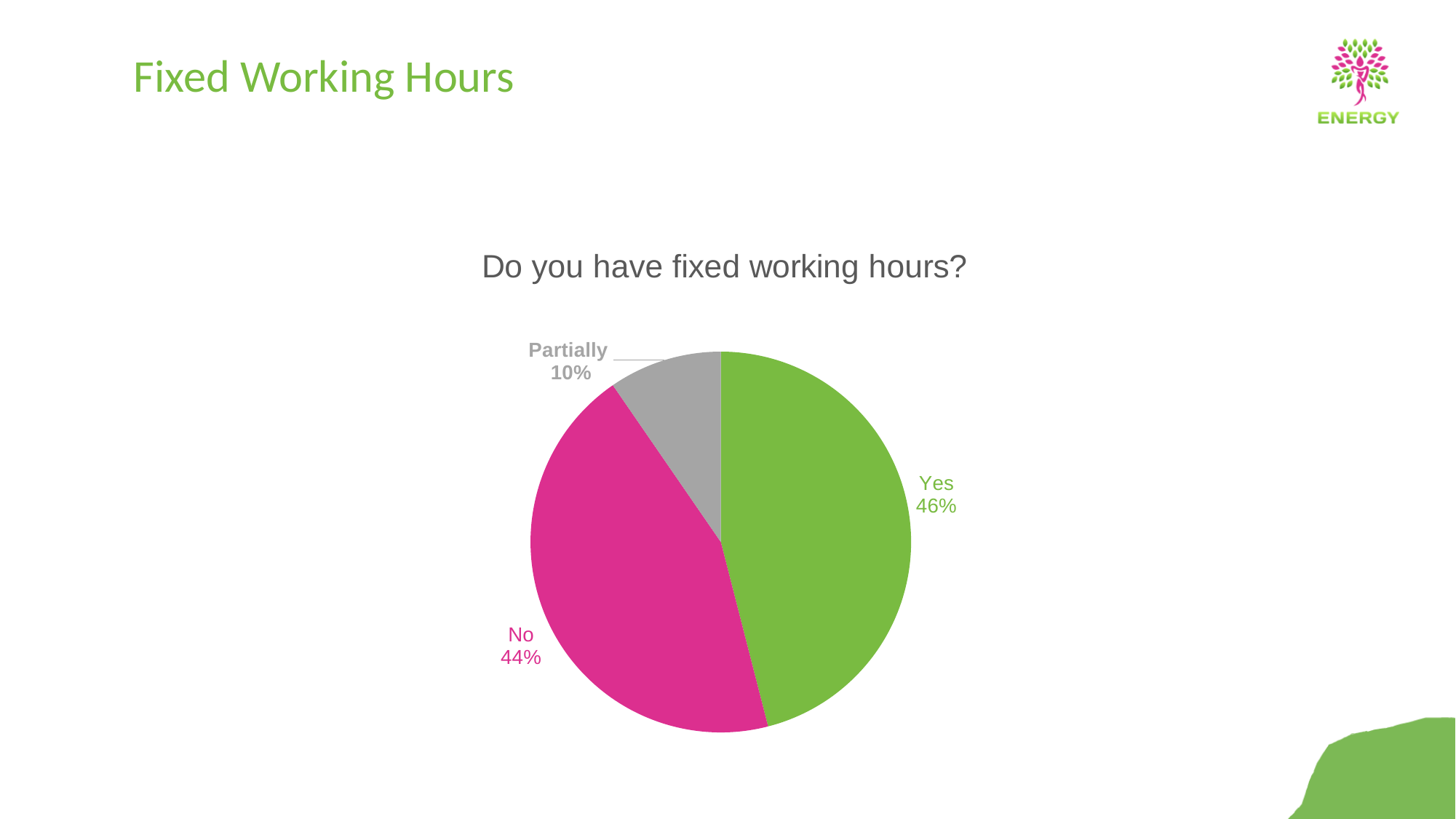
What is the title of the chart? Do you have fixed working hours? What type of chart is shown on the slide? Pie chart How many response categories are shown in the pie chart? 3 What is the difference in percentage points between the "No" and "Partially" shares? 34 percentage points What percentage of respondents answered "No"? 44% Which response has the largest share of the pie? Yes What colour is the "No" slice of the pie chart? Pink What percentage of respondents answered "Partially"? 10% What percentage of respondents answered "Yes" to having fixed working hours? 46% What is the difference in percentage points between the "Yes" and "No" shares? 2 percentage points Which response has the smallest share of the pie? Partially Which is larger, the share for "No" or the share for "Partially"? No